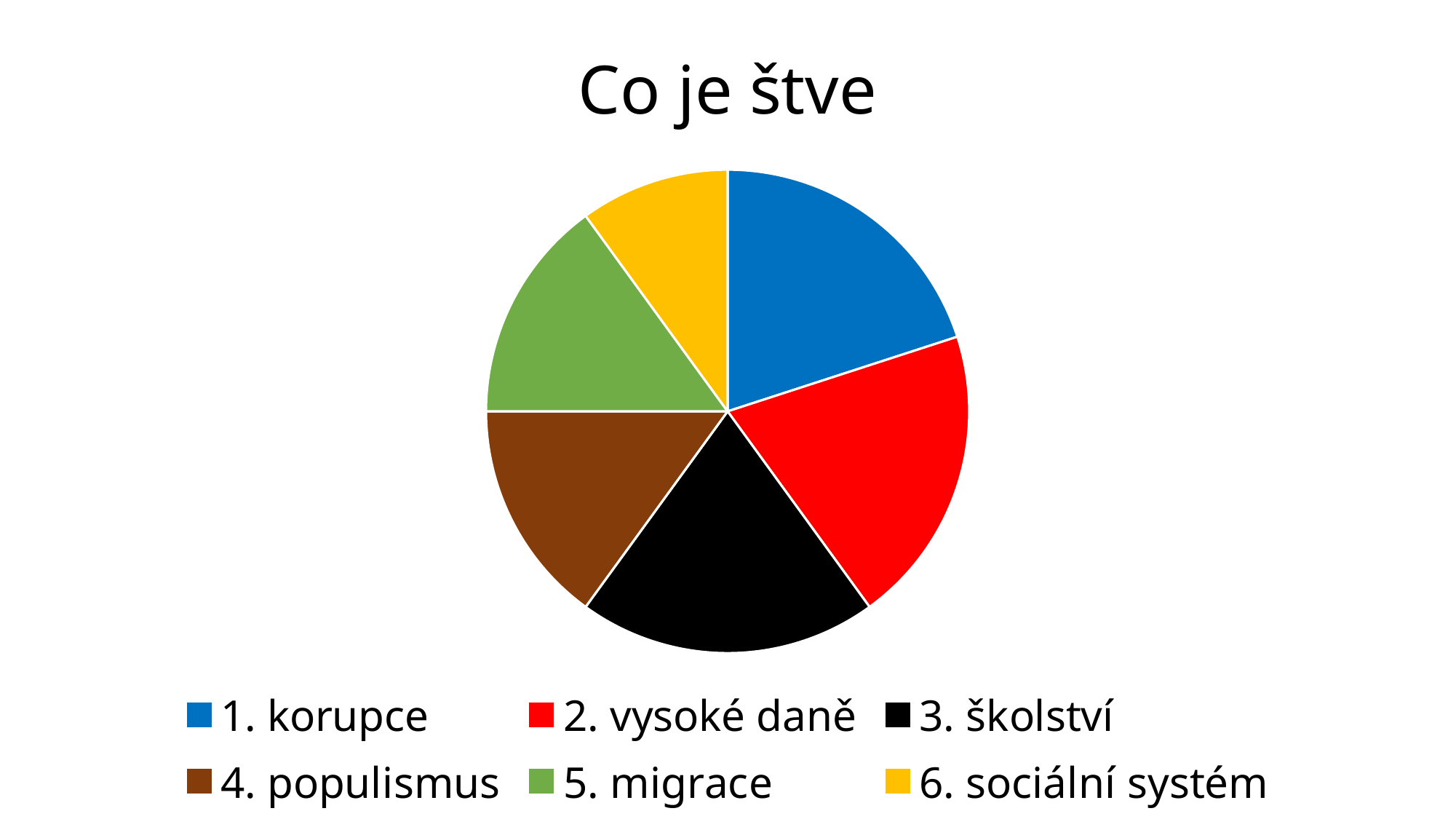
Which category has the smallest slice of the pie? 6. sociální systém Which slice is larger, 5. migrace or 6. sociální systém? 5. migrace Which slice is larger, 3. školství or 6. sociální systém? 3. školství What kind of chart is shown on the slide? pie chart What colour is the slice for 3. školství? black What is the title of the chart? Co je štve How many entries does the legend list? 6 Which slice is larger, 2. vysoké daně or 4. populismus? 2. vysoké daně How many slices does the pie chart have? 6